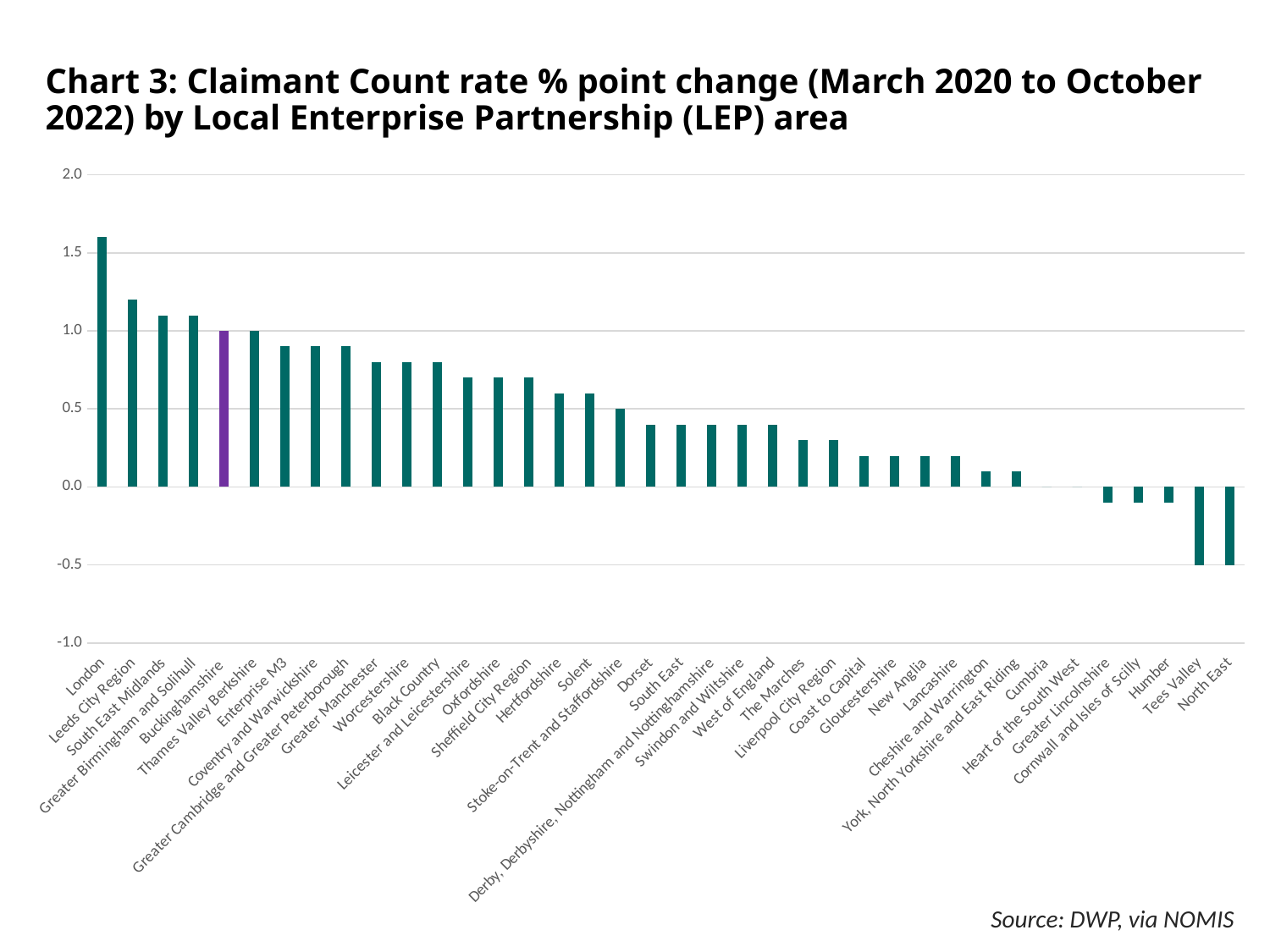
Is the value for Leeds City Region greater or less than 1.0? greater Is the value for Greater Manchester greater or less than 0.5? greater Which LEP area is highlighted with a purple bar? Buckinghamshire Is the value for Dorset greater or less than 0.5? less What is the Claimant Count rate % point change for Tees Valley? -0.5 Which has the larger value, London or Leeds City Region? London What kind of chart is shown on the slide? bar chart Which LEP area has the highest Claimant Count rate % point change? London What is the Claimant Count rate % point change for Buckinghamshire? 1.0 Do the values rise or fall moving from left to right along the x axis? fall